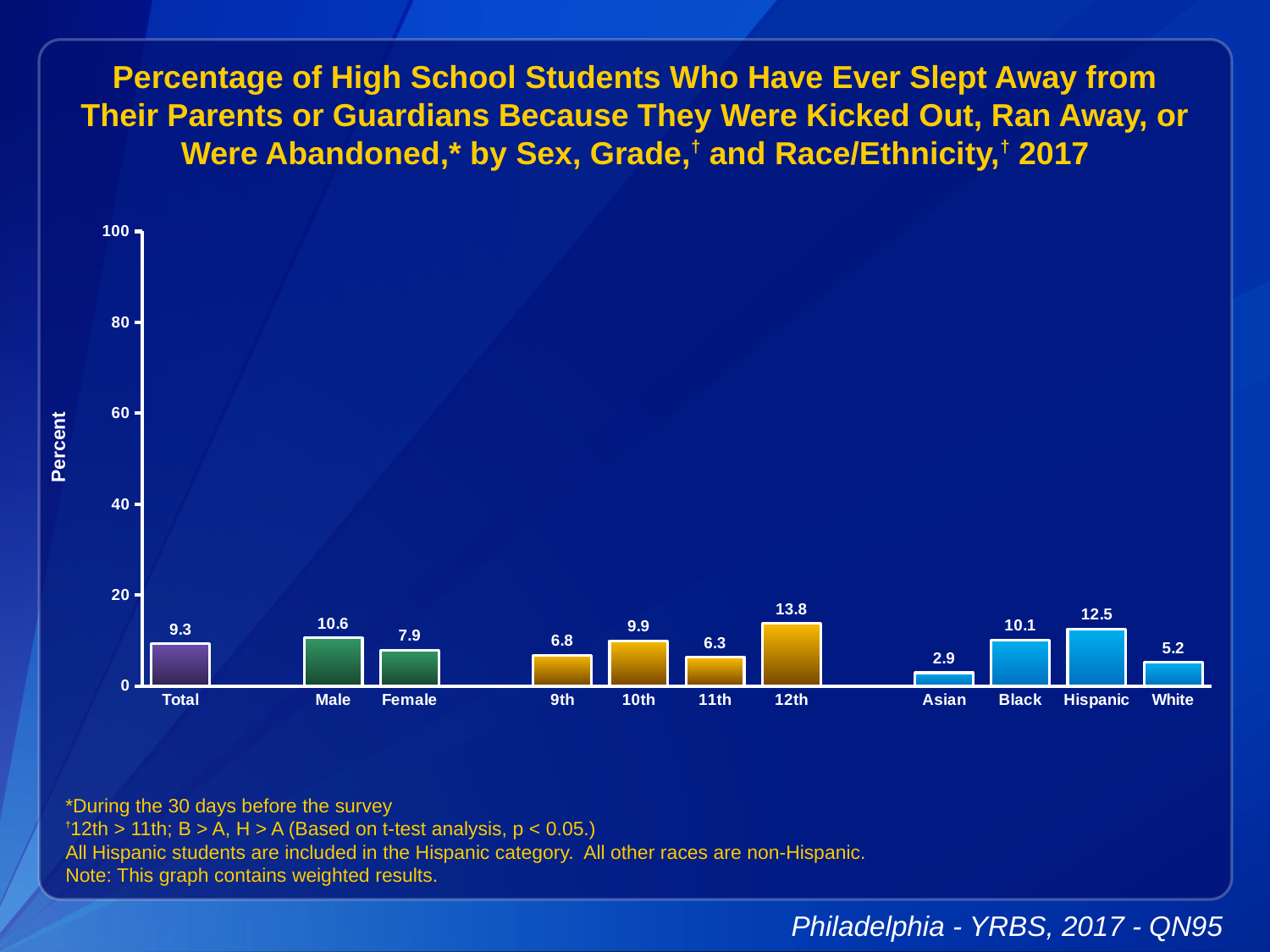
Is the value for 12th grade greater or less than 20? less What is the value for Asian students? 2.9 Which category has the lowest value? Asian What is the value for Total? 9.3 What kind of chart is this? bar chart What is the label on the y axis? Percent What is the difference between the Male and Female values? 2.7 What is the value for 12th grade? 13.8 How many categories are shown on the x axis? 11 What is the value for Male? 10.6 Which category has the highest value? 12th Which is larger, the value for Black or the value for Hispanic? Hispanic